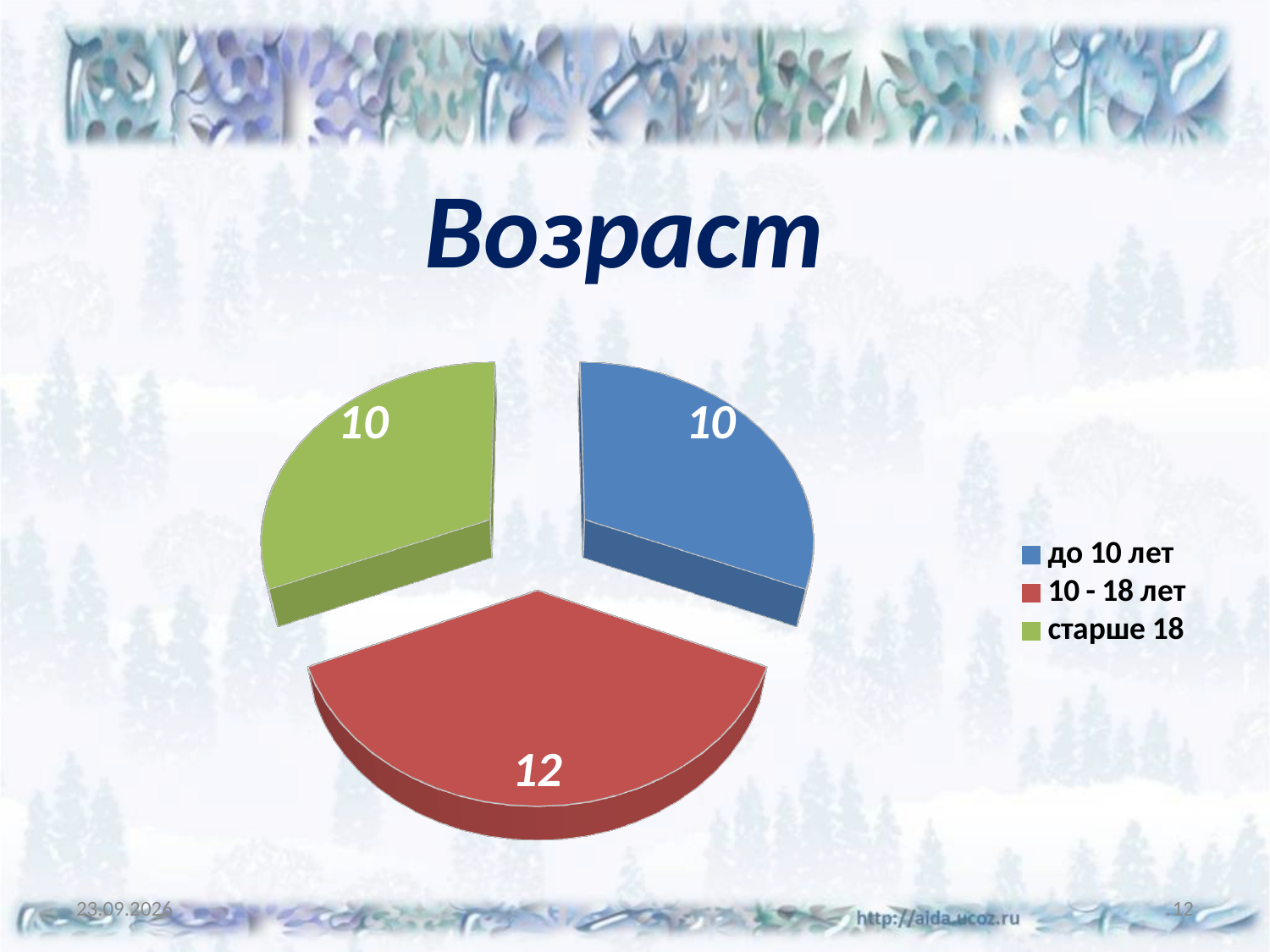
What kind of chart is shown on the slide? pie chart Which colour represents the category "старше 18" in the legend? green What is the value for the slice "10 - 18 лет"? 12 What is the difference between the value for "10 - 18 лет" and the value for "до 10 лет"? 2 How many entries does the legend list? 3 How many slices does the pie chart have? 3 What is the total of all slices in the pie chart? 32 What is the value for the slice "до 10 лет"? 10 What is the value for the slice "старше 18"? 10 Which category has the largest slice? 10 - 18 лет What is the title of the chart? Возраст Which is larger, the value for "10 - 18 лет" or the value for "старше 18"? 10 - 18 лет